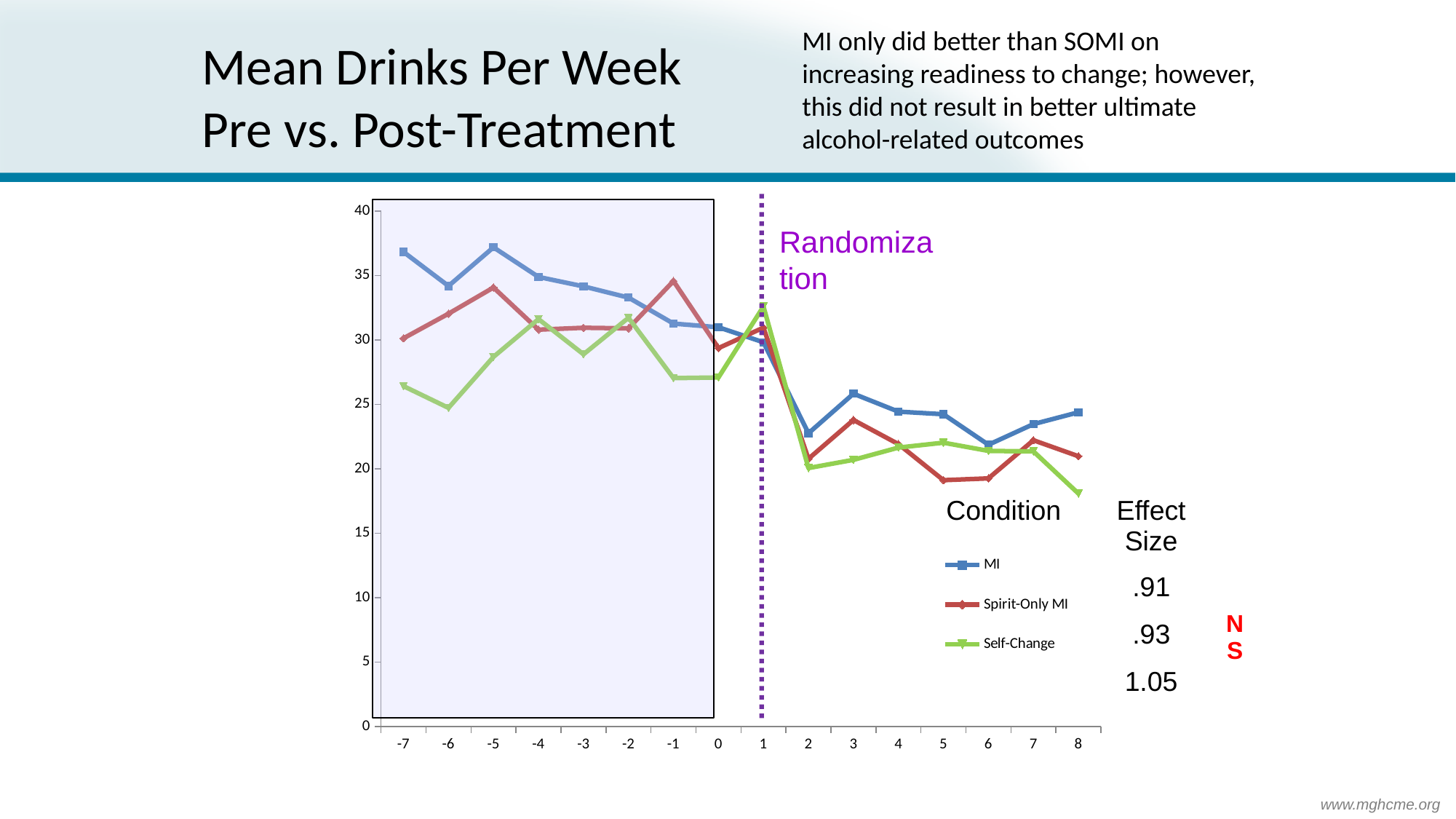
Does the MI line rise or fall from week 1 to week 2? fall At week 3, which series has the higher value, MI or Spirit-Only MI? MI How many time points are shown along the x axis? 16 Is the value for MI at week -7 greater or less than 35? greater What are the three conditions listed in the legend? MI, Spirit-Only MI, Self-Change What kind of chart is shown on the slide? line chart At week -7, which series has the higher value, MI or Self-Change? MI How many series does the legend list? 3 Is the value for Spirit-Only MI at week 5 greater or less than 20? less Is the value for Self-Change at week 8 greater or less than 20? less Which series has the lowest value at week 8? Self-Change